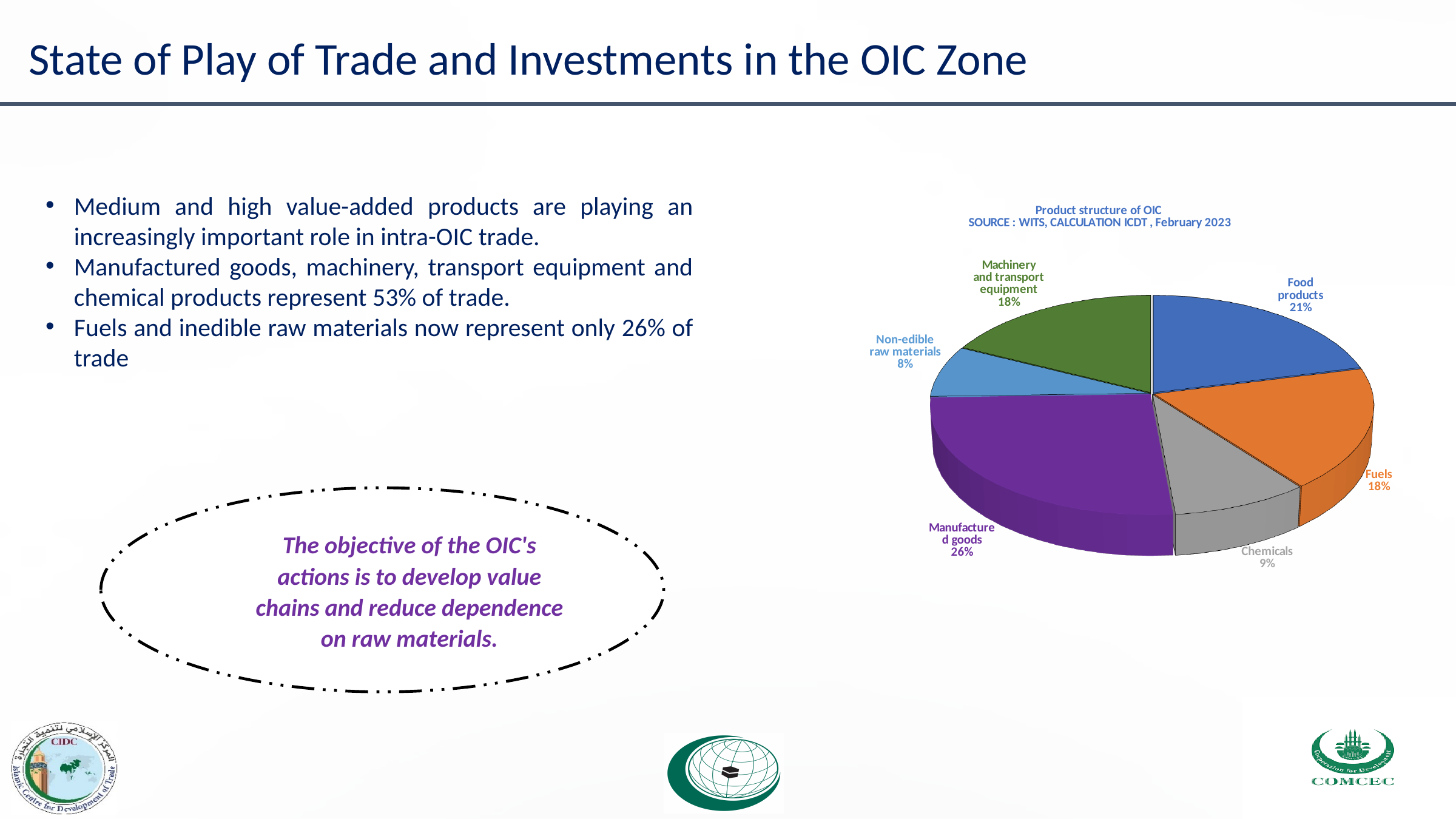
Which is larger, the share for Food products or the share for Chemicals? Food products What is the difference in percentage points between Manufactured goods and Food products? 5 What share of the pie does Non-edible raw materials represent? 8% How many categories are shown in the pie chart? 6 Which category has the largest share of the pie? Manufactured goods What colour is the Fuels slice? Orange What share of the pie does Manufactured goods represent? 26% What share of the pie does Food products represent? 21% What kind of chart is shown on the slide? Pie chart What is the title of the chart? Product structure of OIC Which category has the smallest share of the pie? Non-edible raw materials What share of the pie does Chemicals represent? 9%